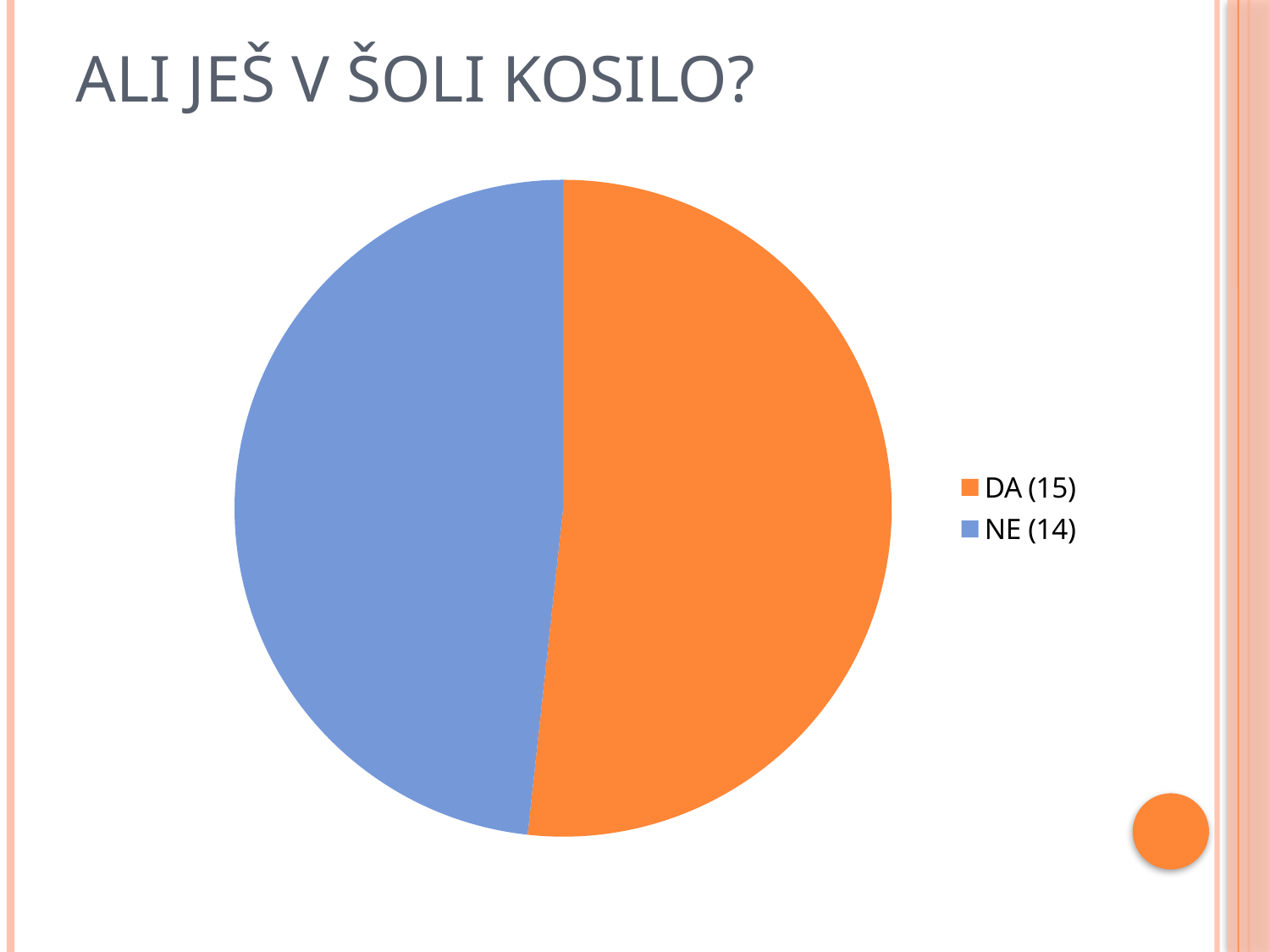
How many entries does the legend list? 2 What is the difference between the values for DA and NE? 1 Which category has the lowest value? NE What kind of chart is shown on the slide? pie chart Which category has the highest value? DA What is the total of the values for DA and NE? 29 What is the value for NE? 14 Which category has the larger value, DA or NE? DA What is the title of the chart on the slide? ALI JEŠ V ŠOLI KOSILO? How many slices does the pie chart have? 2 Which colour represents NE in the pie chart? blue What is the value for DA? 15